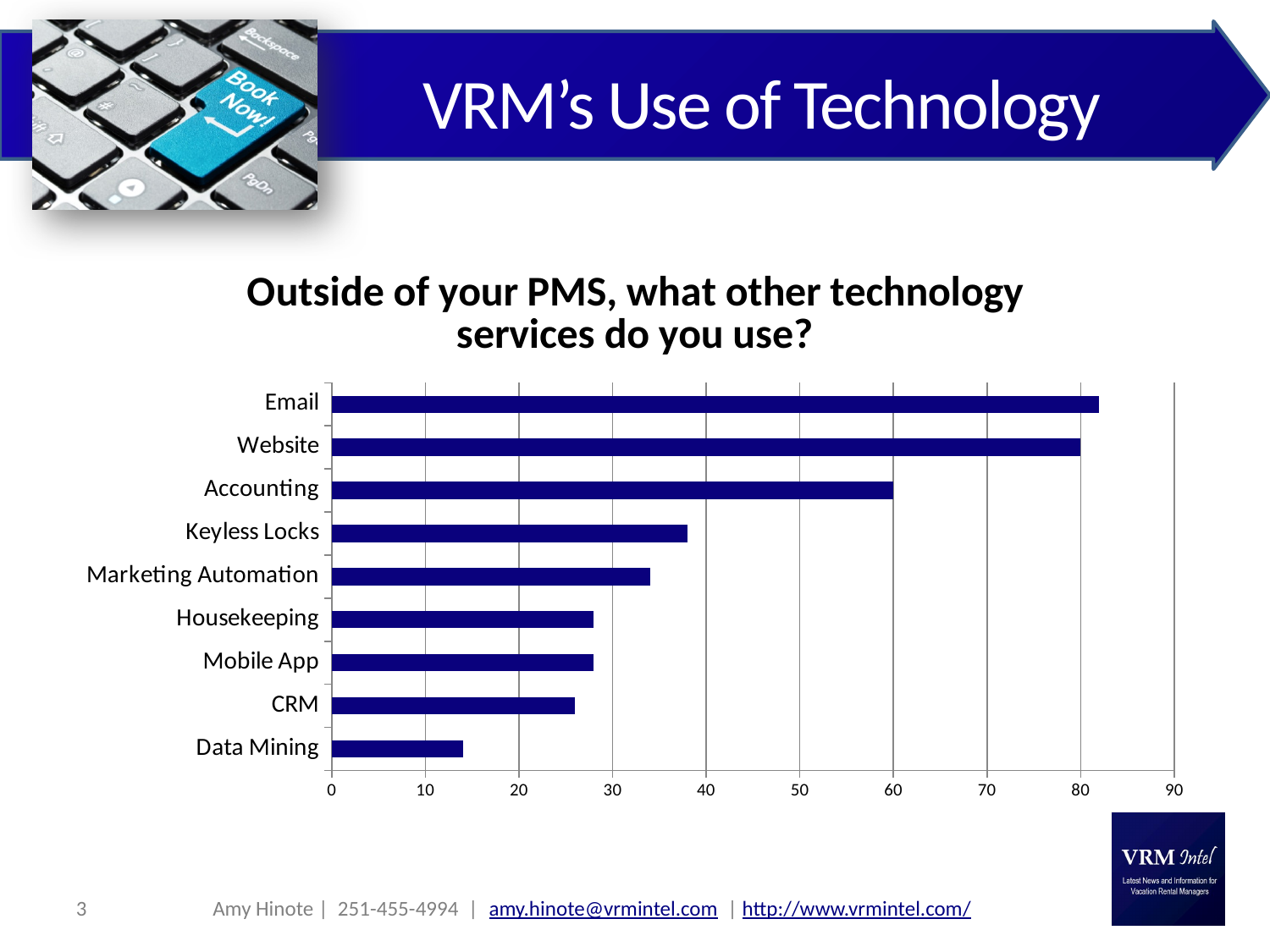
Is the value for Keyless Locks greater or less than 40? less What is the value for Website? 80 Is the value for Data Mining greater or less than 20? less What is the title of the chart? Outside of your PMS, what other technology services do you use? How many technology services are listed on the chart? 9 Is the value for CRM greater or less than 30? less Which technology service has the lowest value? Data Mining What kind of chart is shown on the slide? bar chart Which is larger, the value for CRM or the value for Data Mining? CRM Which is larger, the value for Accounting or the value for Keyless Locks? Accounting What is the value for Accounting? 60